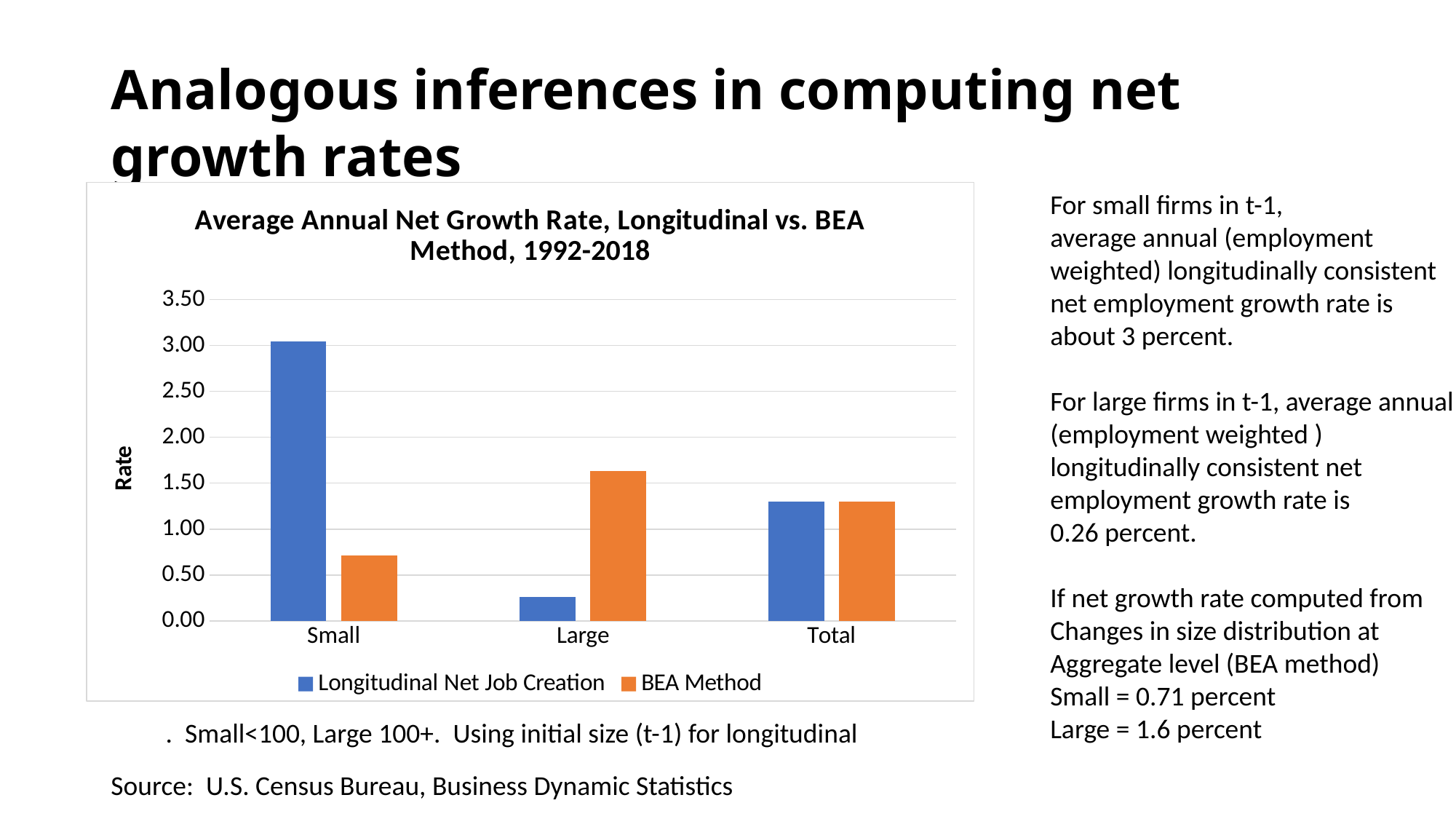
How many categories are shown on the x axis of the chart? 3 For Small firms, which series has the larger value: Longitudinal Net Job Creation or BEA Method? Longitudinal Net Job Creation How many series does the legend of the chart list? 2 Which category has the highest value for the BEA Method? Large Which category has the lowest value for the BEA Method? Small For Large firms, which series has the larger value: Longitudinal Net Job Creation or BEA Method? BEA Method What is the title of the chart? Average Annual Net Growth Rate, Longitudinal vs. BEA Method, 1992-2018 Is the Longitudinal Net Job Creation value for Small greater or less than 2.50? greater Which category has the highest value for Longitudinal Net Job Creation? Small What type of chart is shown on the slide? bar chart Is the BEA Method value for Large greater or less than 1.50? greater Which category has the lowest value for Longitudinal Net Job Creation? Large